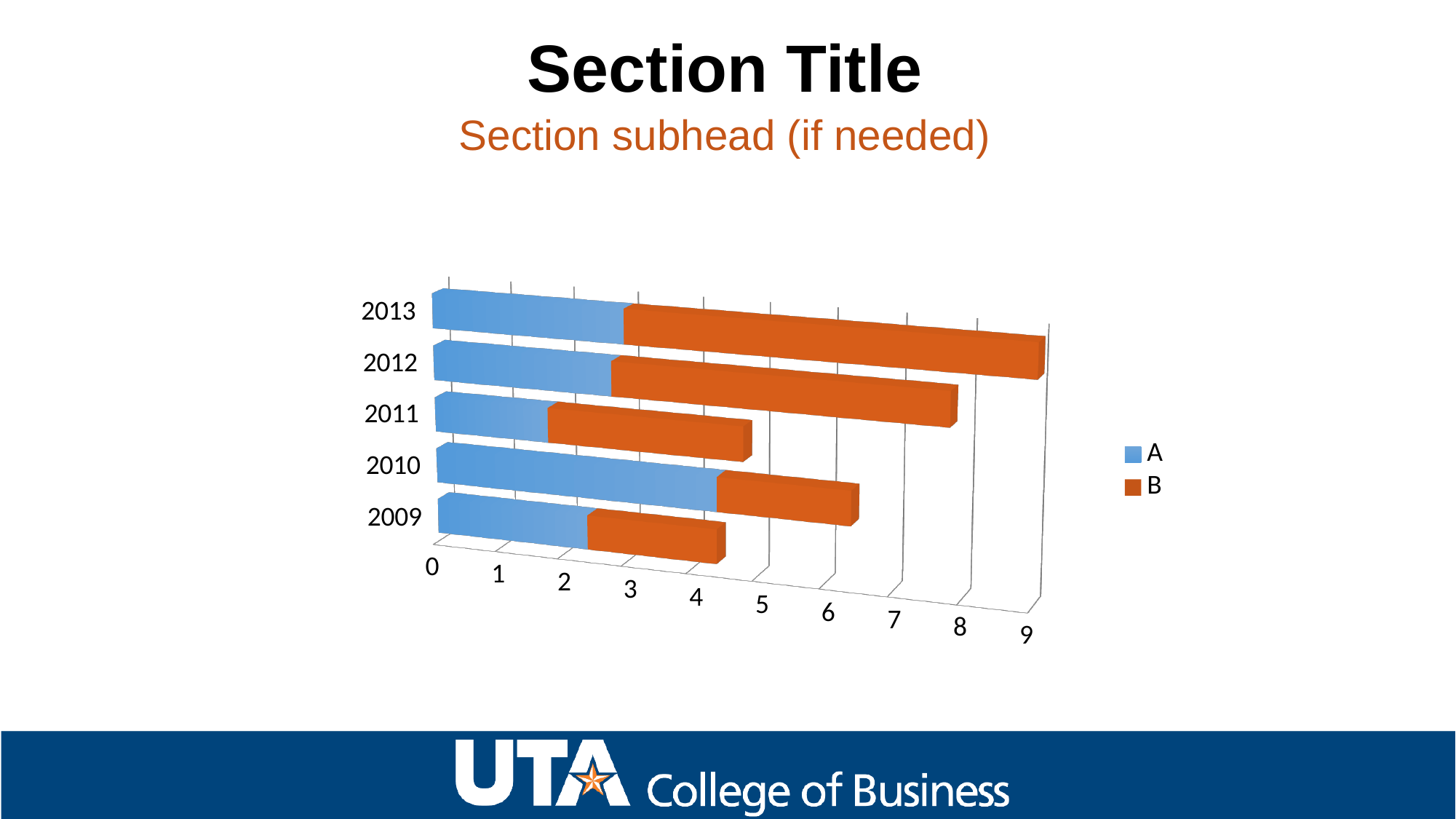
Which is larger, the series A value for 2010 or the series A value for 2011? 2010 How many years (categories) are plotted on the chart? 5 Which colour represents series B? Orange Which is larger, the total bar for 2013 or the total bar for 2009? 2013 Which year has the largest series A segment? 2010 What kind of chart is shown on the slide? Stacked bar chart Is the total stacked bar for 2009 greater or less than 6? less Is the total stacked bar for 2013 greater or less than 5? greater What are the names of the series in the legend? A and B How many series does the chart's legend list? 2 Which year has the longest total stacked bar? 2013 Is the total stacked bar for 2012 greater or less than 6? greater